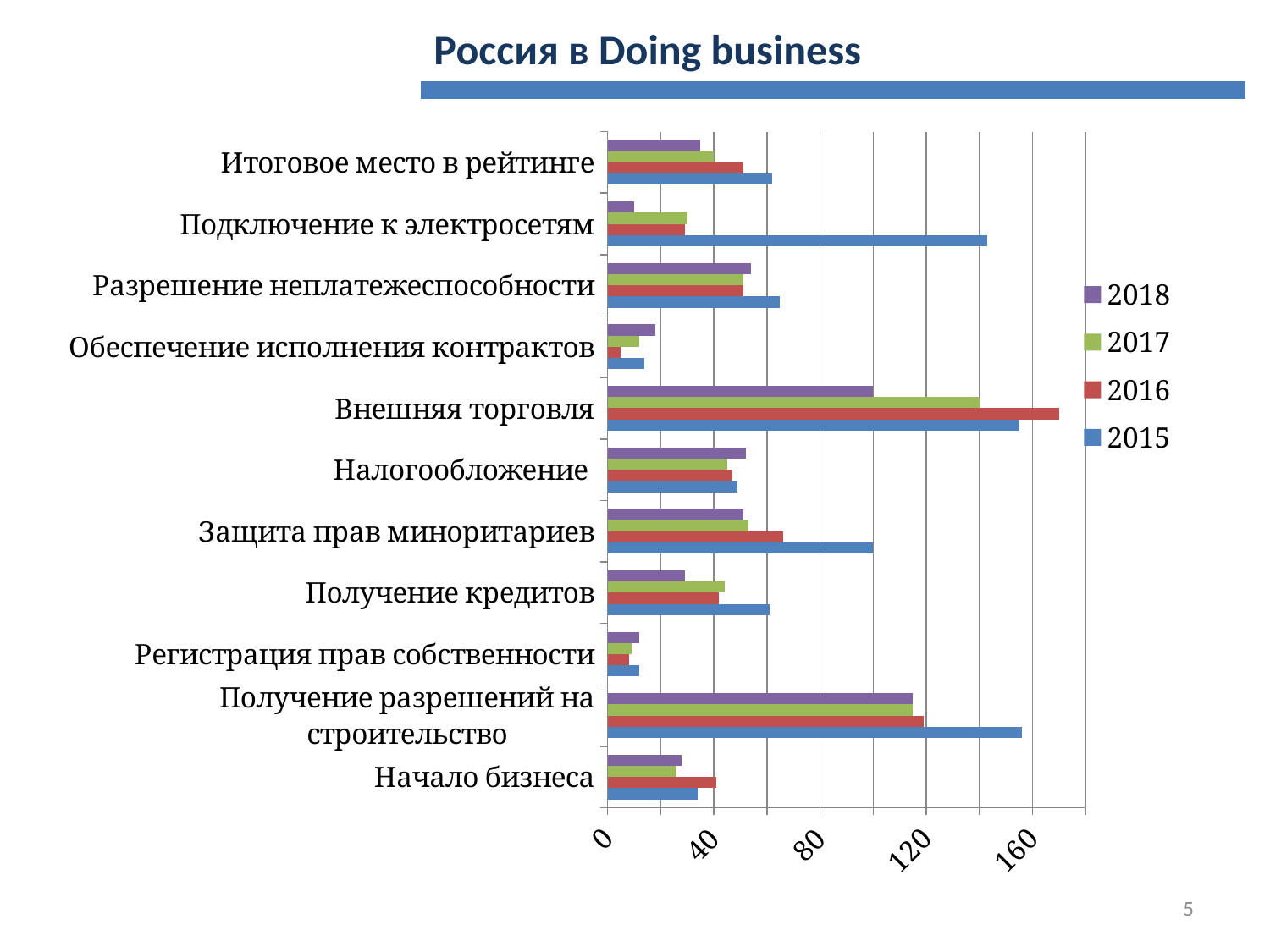
Is the 2015 value for Получение разрешений на строительство greater or less than 120? greater Is the 2015 value for Подключение к электросетям greater or less than 120? greater For the 2016 series, which category has the highest value? Внешняя торговля For Подключение к электросетям, which series has the largest value? 2015 Is the 2015 value for Обеспечение исполнения контрактов greater or less than 40? less For Внешняя торговля, which is larger: the 2016 value or the 2015 value? 2016 Which years are listed in the chart legend? 2018, 2017, 2016, 2015 How many series does the legend list? 4 What kind of chart is shown on the slide? Bar chart How many categories are shown on the vertical axis of the chart? 11 What is the title of the slide containing the chart? Россия в Doing business